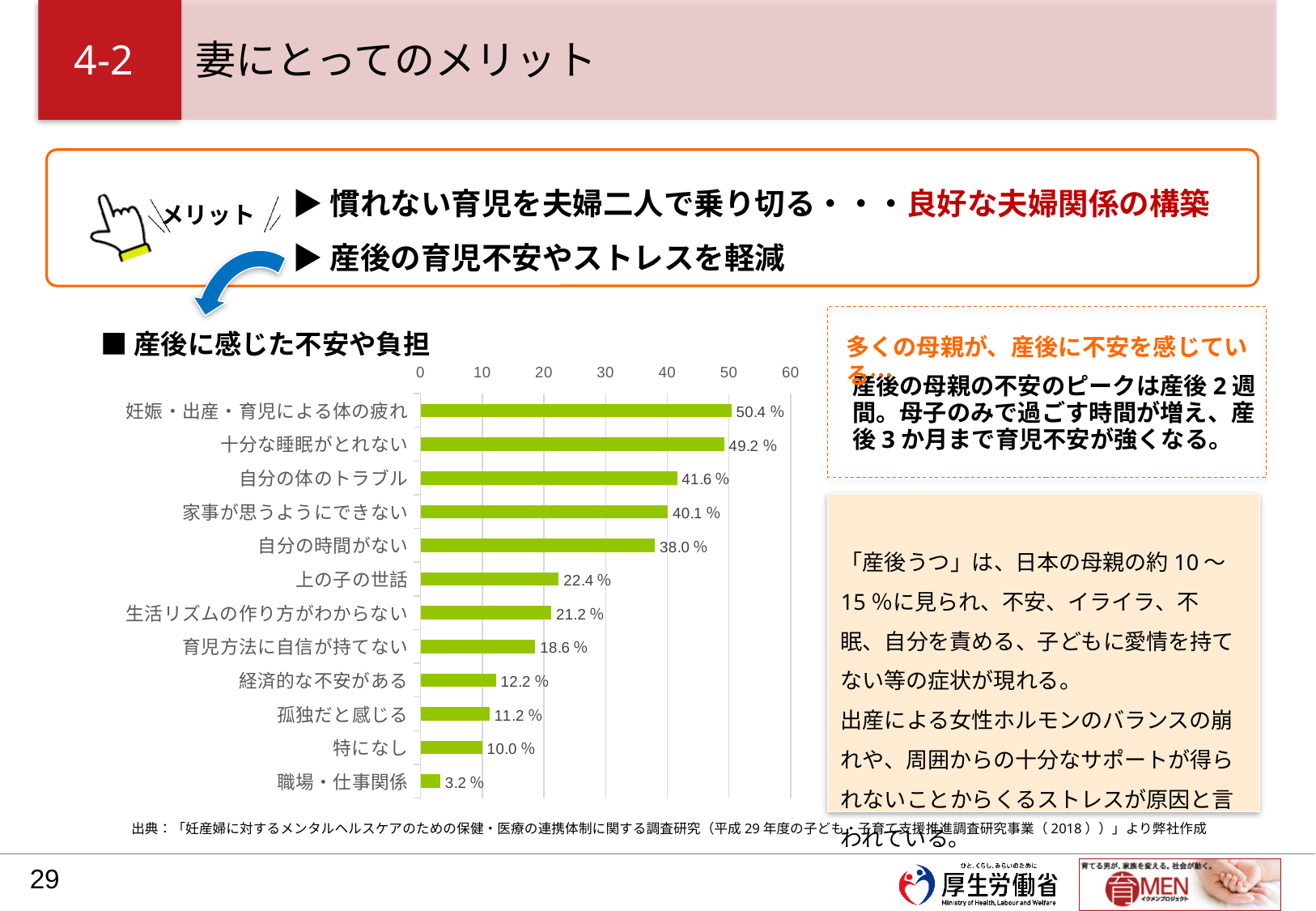
What is the value for 自分の時間がない? 38.0 % Which is larger, the value for 上の子の世話 or the value for 育児方法に自信が持てない? 上の子の世話 Is the value for 家事が思うようにできない greater or less than 30? greater What is the value for 妊娠・出産・育児による体の疲れ? 50.4 % What is the title of the chart? 産後に感じた不安や負担 How many categories are shown in the chart? 12 What is the difference between the values for 十分な睡眠がとれない and 自分の体のトラブル? 7.6 % What kind of chart is shown on the slide? bar chart Which category has the highest value? 妊娠・出産・育児による体の疲れ What is the value for 職場・仕事関係? 3.2 % Which category has the lowest value? 職場・仕事関係 What is the value for 特になし? 10.0 %